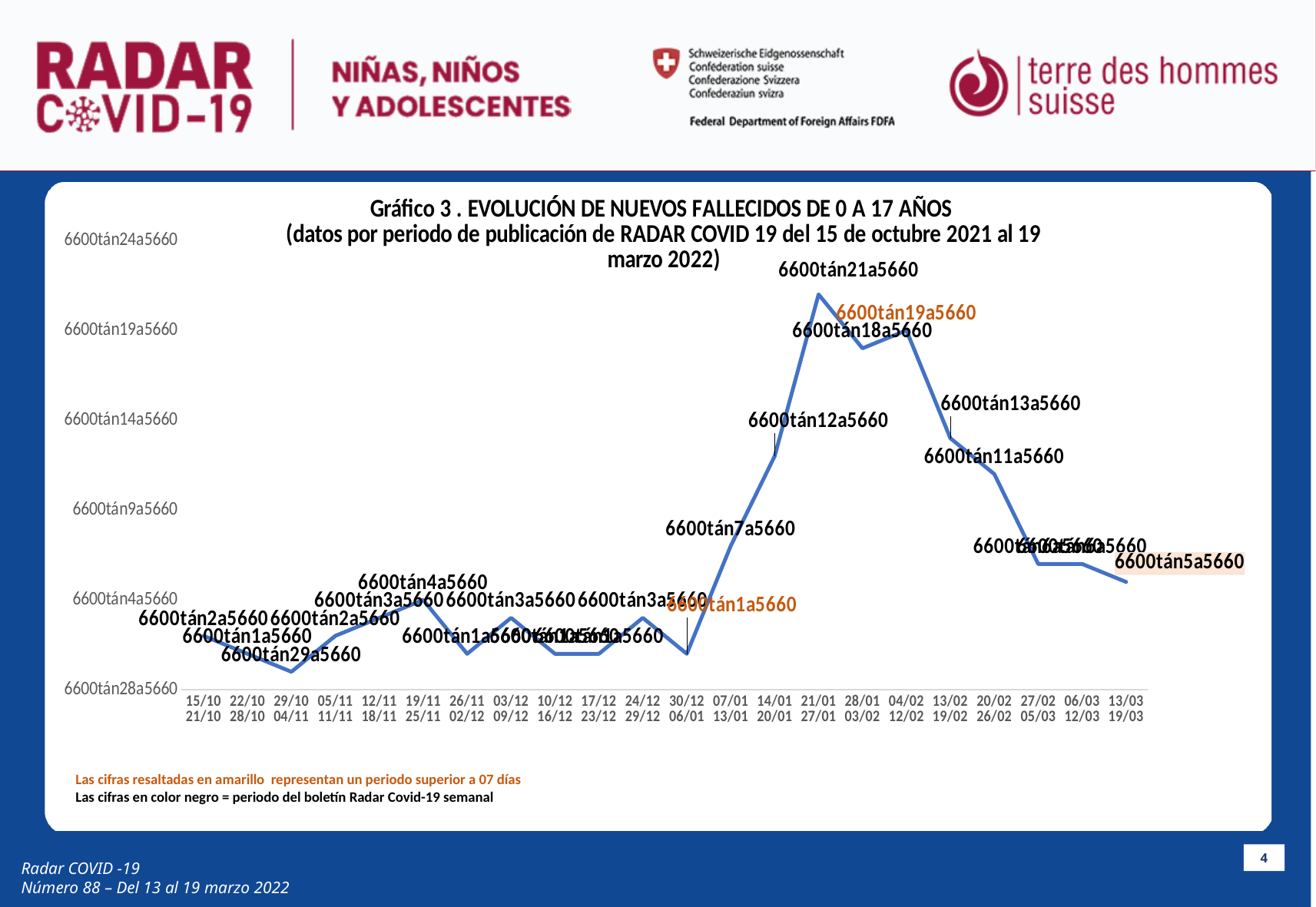
What is the title of the chart (first line)? Gráfico 3 . EVOLUCIÓN DE NUEVOS FALLECIDOS DE 0 A 17 AÑOS Which period has the highest value on the line? 21/01 - 27/01 How many data series (lines) are plotted on the chart? 1 Which period has the lowest value on the line? 29/10 - 04/11 Do the values rise or fall from the 30/12 - 06/01 period to the 21/01 - 27/01 period? Rise How many publication periods are shown along the x axis? 22 According to the note below the chart, what do the figures highlighted in yellow/orange represent? A period longer than 07 days Do the values rise or fall from the 21/01 - 27/01 period to the 13/03 - 19/03 period? Fall What kind of chart is Gráfico 3? Line chart Which period has the larger value, 07/01 - 13/01 or 14/01 - 20/01? 14/01 - 20/01 Which period has the larger value, 21/01 - 27/01 or 13/03 - 19/03? 21/01 - 27/01